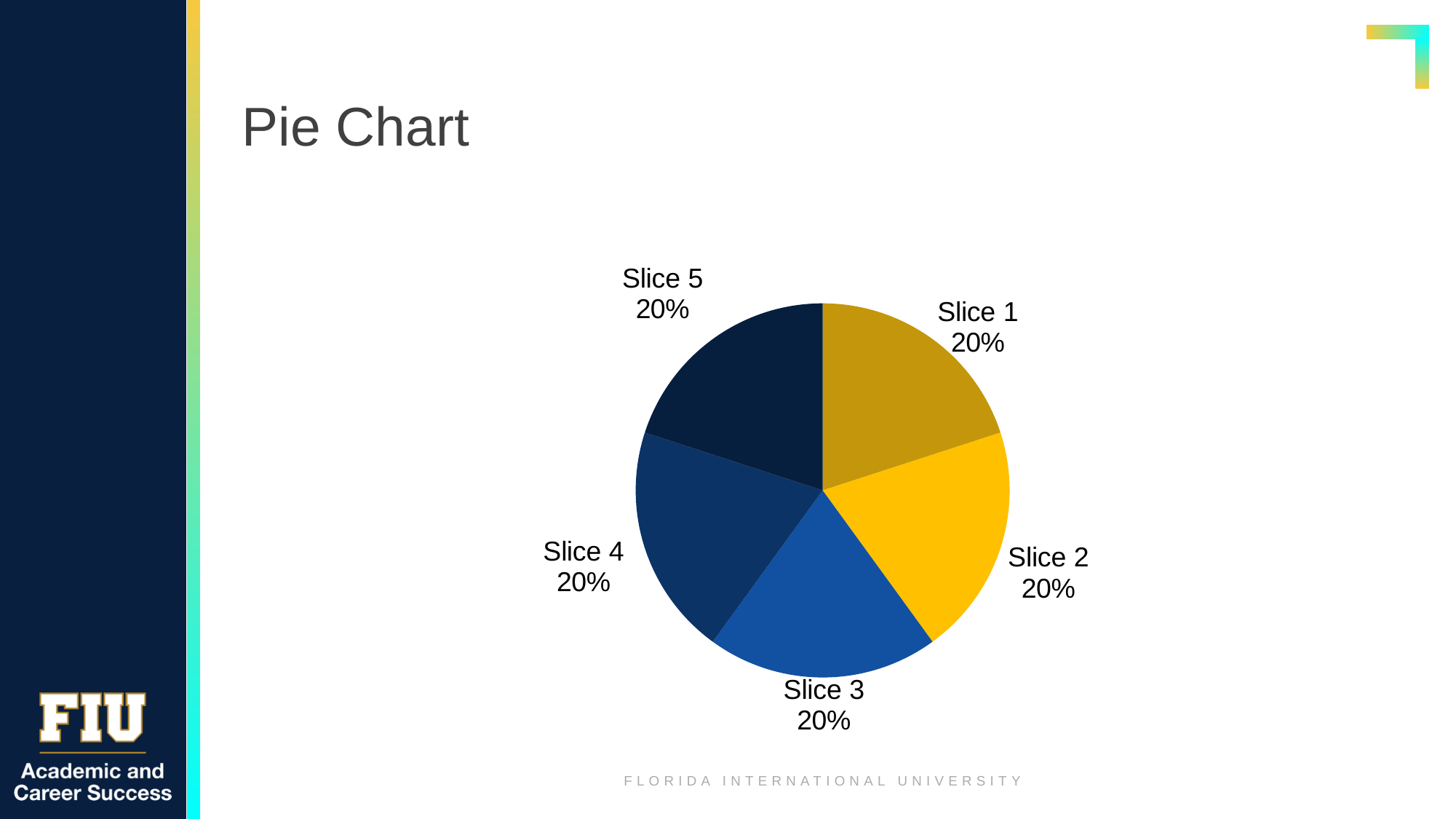
What is the title of the slide containing the pie chart? Pie Chart What share of the pie does Slice 5 represent? 20% What share of the pie does Slice 3 represent? 20% What is the combined share of Slice 2 and Slice 3? 40% How many slices does the pie chart have? 5 What share of the pie does Slice 1 represent? 20% What is the difference between the shares of Slice 1 and Slice 4? 0% Which slice is shown in the darkest navy colour? Slice 5 What is the value labelled for Slice 2? 20% What is the value labelled for Slice 4? 20% What kind of chart is shown on the slide? pie chart